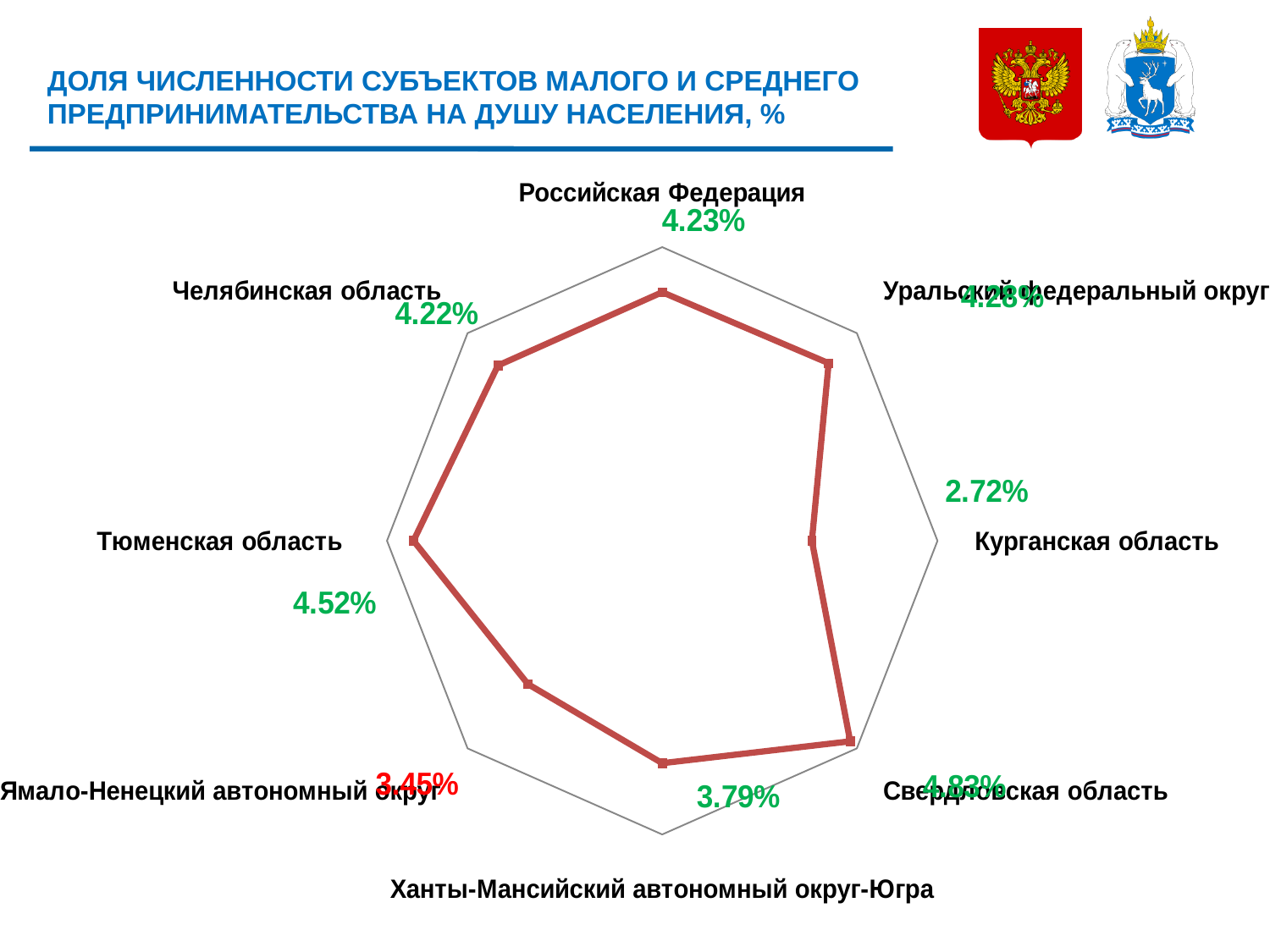
Which is larger, the value for Тюменская область or for Ханты-Мансийский автономный округ-Югра? Тюменская область Which region has the highest value on the chart? Свердловская область Which region has the lowest value on the chart? Курганская область What is the value for Курганская область? 2.72% What is the value for Российская Федерация? 4.23% What is the value for Ханты-Мансийский автономный округ-Югра? 3.79% What is the value for Челябинская область? 4.22% What is the difference between the values for Тюменская область and Ямало-Ненецкий автономный округ? 1.07 percentage points What kind of chart is shown on the slide? Radar chart What is the value for Тюменская область? 4.52% How many regions are plotted on the chart? 8 What is the value for Ямало-Ненецкий автономный округ? 3.45%